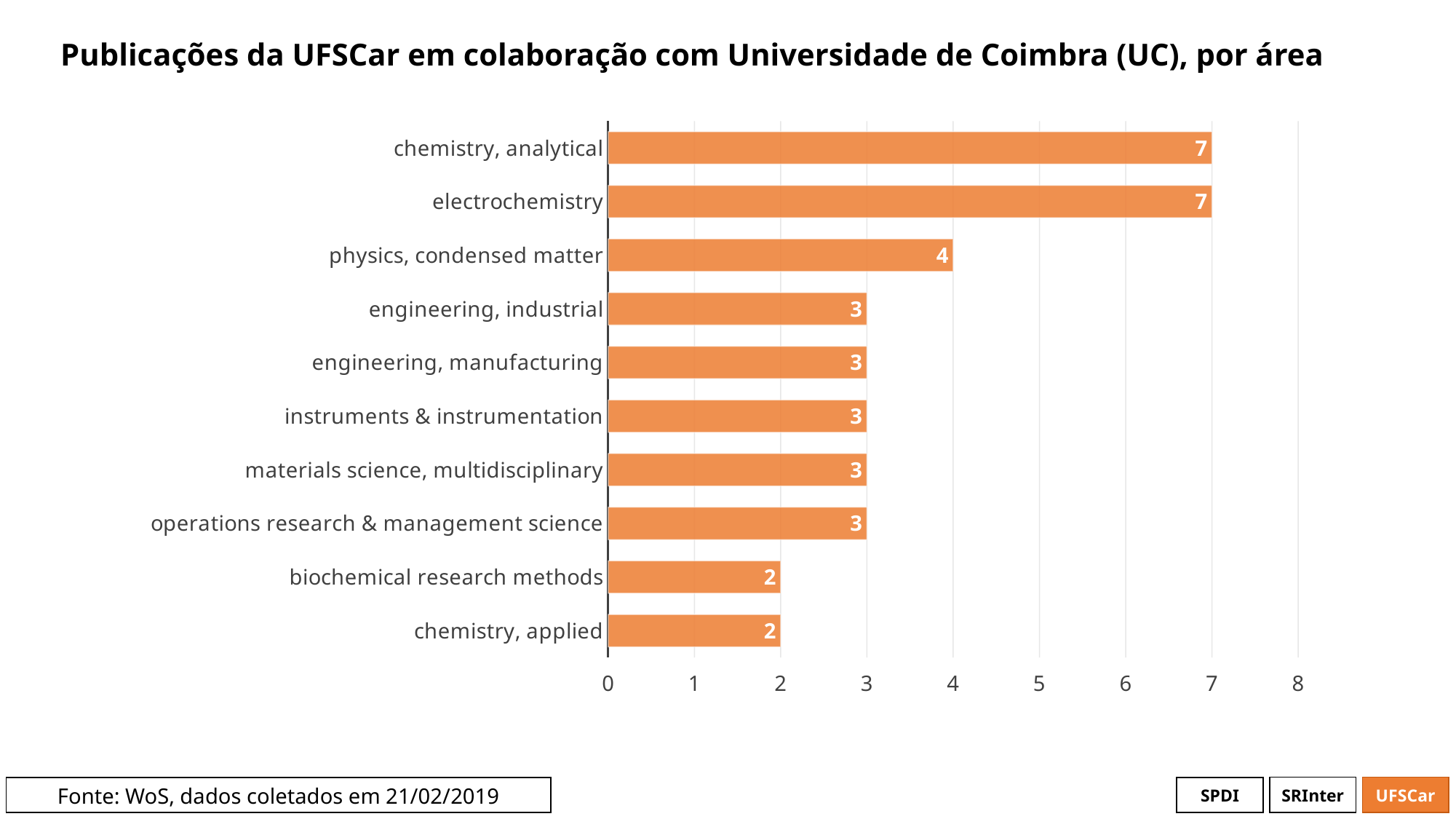
What kind of chart is shown on the slide? bar chart What is the value for physics, condensed matter? 4 What is the value for biochemical research methods? 2 Which is larger, the value for electrochemistry or the value for materials science, multidisciplinary? electrochemistry Which categories have the highest value? chemistry, analytical and electrochemistry What is the value for electrochemistry? 7 What is the title of the chart? Publicações da UFSCar em colaboração com Universidade de Coimbra (UC), por área What is the difference between the values for engineering, industrial and chemistry, applied? 1 How many categories are shown in the chart? 10 Which categories have the lowest value? biochemical research methods and chemistry, applied What is the value for operations research & management science? 3 What is the difference between the values for chemistry, analytical and physics, condensed matter? 3